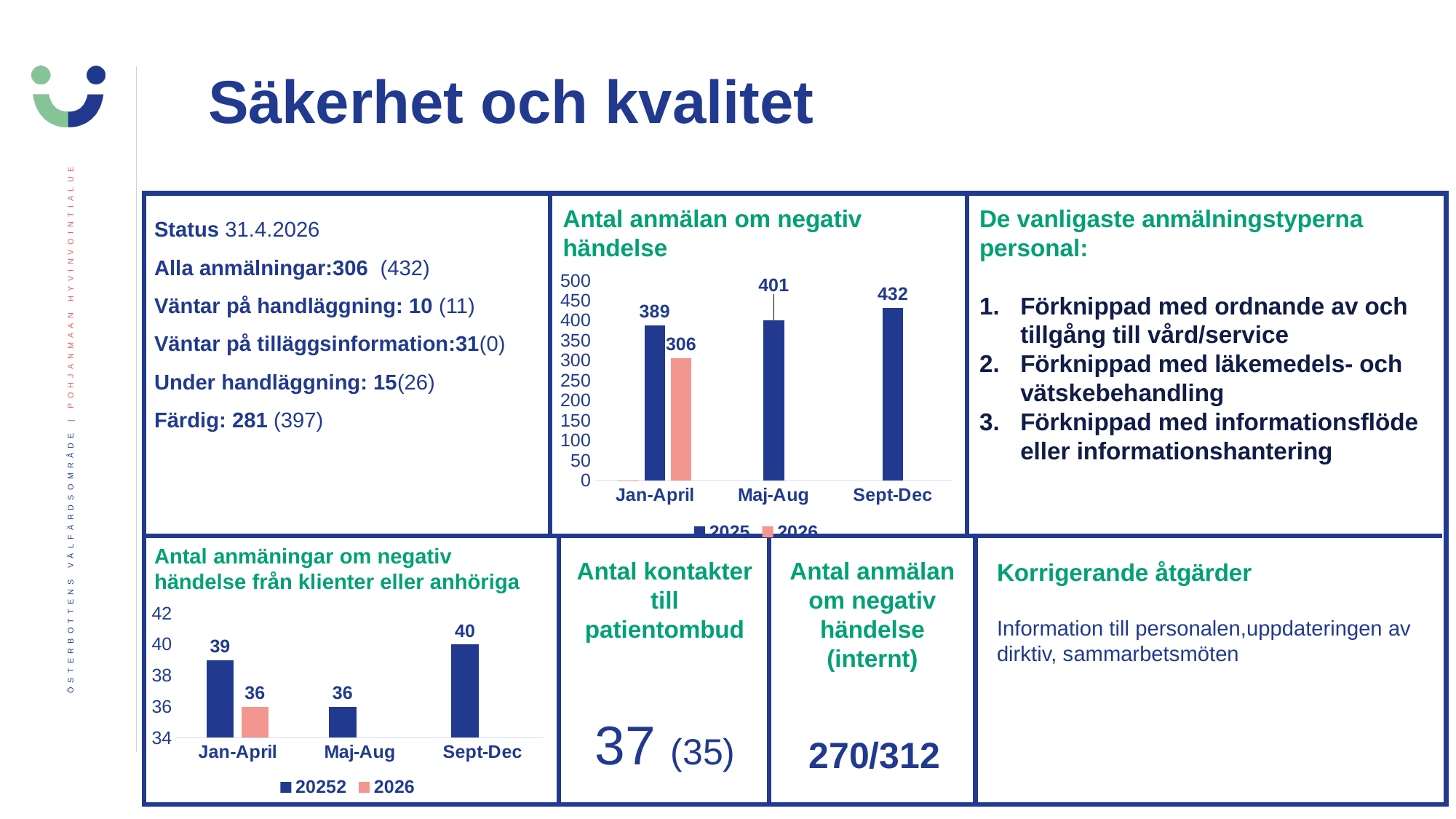
In the chart 'Antal anmäningar om negativ händelse från klienter eller anhöriga', how many periods are shown on the x axis? 3 In the chart 'Antal anmälan om negativ händelse', do the 2025 values rise or fall from Jan-April to Sept-Dec? rise In the chart 'Antal anmälan om negativ händelse', how many series does the legend list? 2 In the chart 'Antal anmälan om negativ händelse', which period has the highest 2025 value? Sept-Dec In the chart 'Antal anmälan om negativ händelse', what is the 2026 value for Jan-April? 306 What type of chart is 'Antal anmäningar om negativ händelse från klienter eller anhöriga'? bar chart In the chart 'Antal anmäningar om negativ händelse från klienter eller anhöriga', what is the 2025 value for Sept-Dec? 40 In the chart 'Antal anmälan om negativ händelse', is the 2025 value for Maj-Aug greater or less than 400? greater In the chart 'Antal anmälan om negativ händelse', what is the difference between the 2025 values for Sept-Dec and Jan-April? 43 In the chart 'Antal anmäningar om negativ händelse från klienter eller anhöriga', which is larger for Jan-April: the 2025 value or the 2026 value? 2025 In the chart 'Antal anmäningar om negativ händelse från klienter eller anhöriga', which period has the lowest 2025 value? Maj-Aug In the chart 'Antal anmälan om negativ händelse', what is the 2025 value for Jan-April? 389